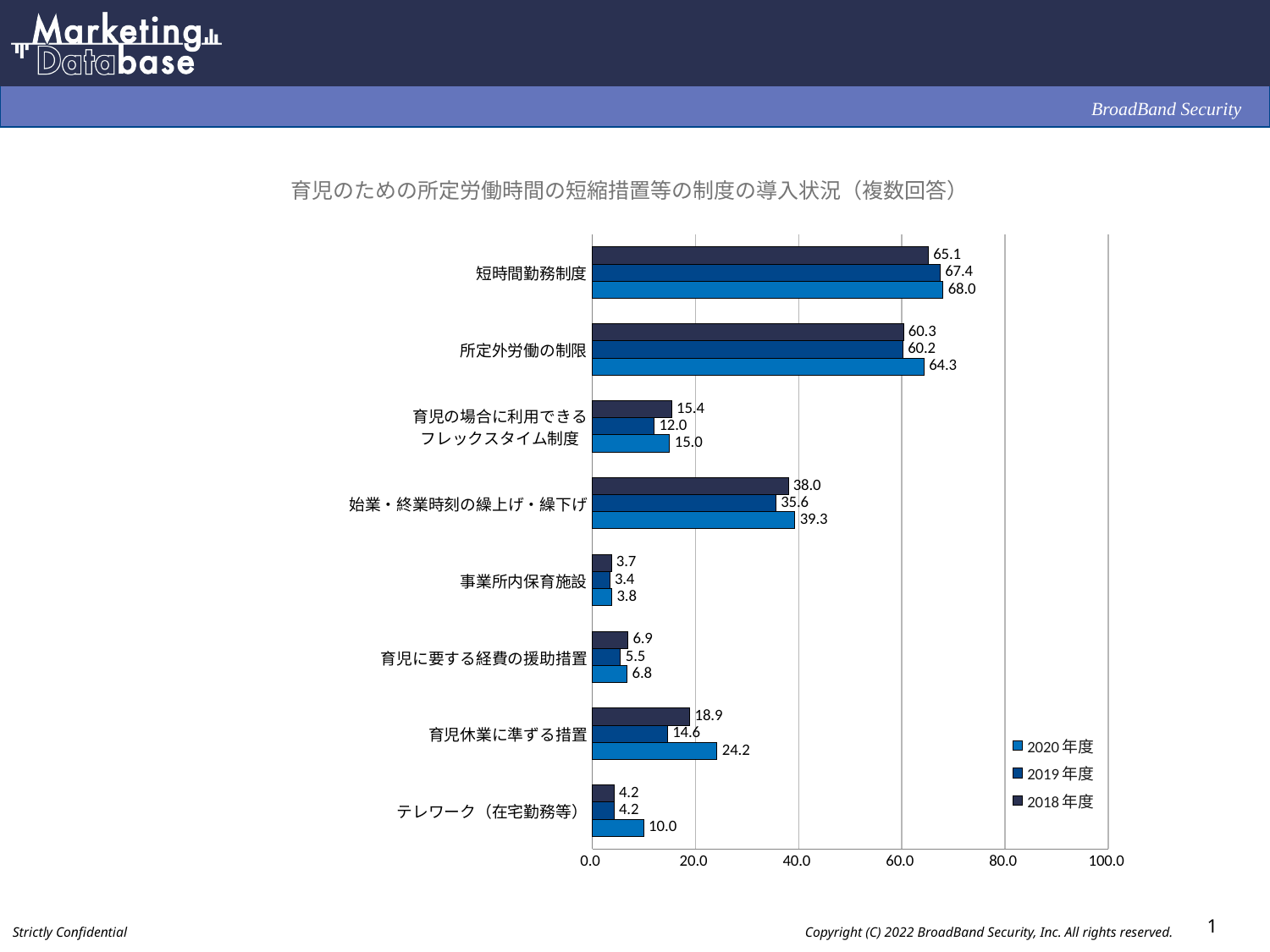
What is the 2018年度 value for 始業・終業時刻の繰上げ・繰下げ? 38.0 Which category has the highest 2020年度 value? 短時間勤務制度 What is the title of the chart? 育児のための所定労働時間の短縮措置等の制度の導入状況（複数回答） What type of chart is shown on the slide? bar chart How many categories are plotted on the chart? 8 What is the 2019年度 value for 育児休業に準ずる措置? 14.6 Is the 2020年度 value for 育児休業に準ずる措置 greater or less than 20.0? greater How many series does the legend list? 3 For 所定外労働の制限, which is larger: the 2020年度 value or the 2018年度 value? 2020年度 What is the difference between the 2020年度 and 2018年度 values for テレワーク（在宅勤務等）? 5.8 What is the 2020年度 value for 短時間勤務制度? 68.0 Which category has the lowest 2019年度 value? 事業所内保育施設